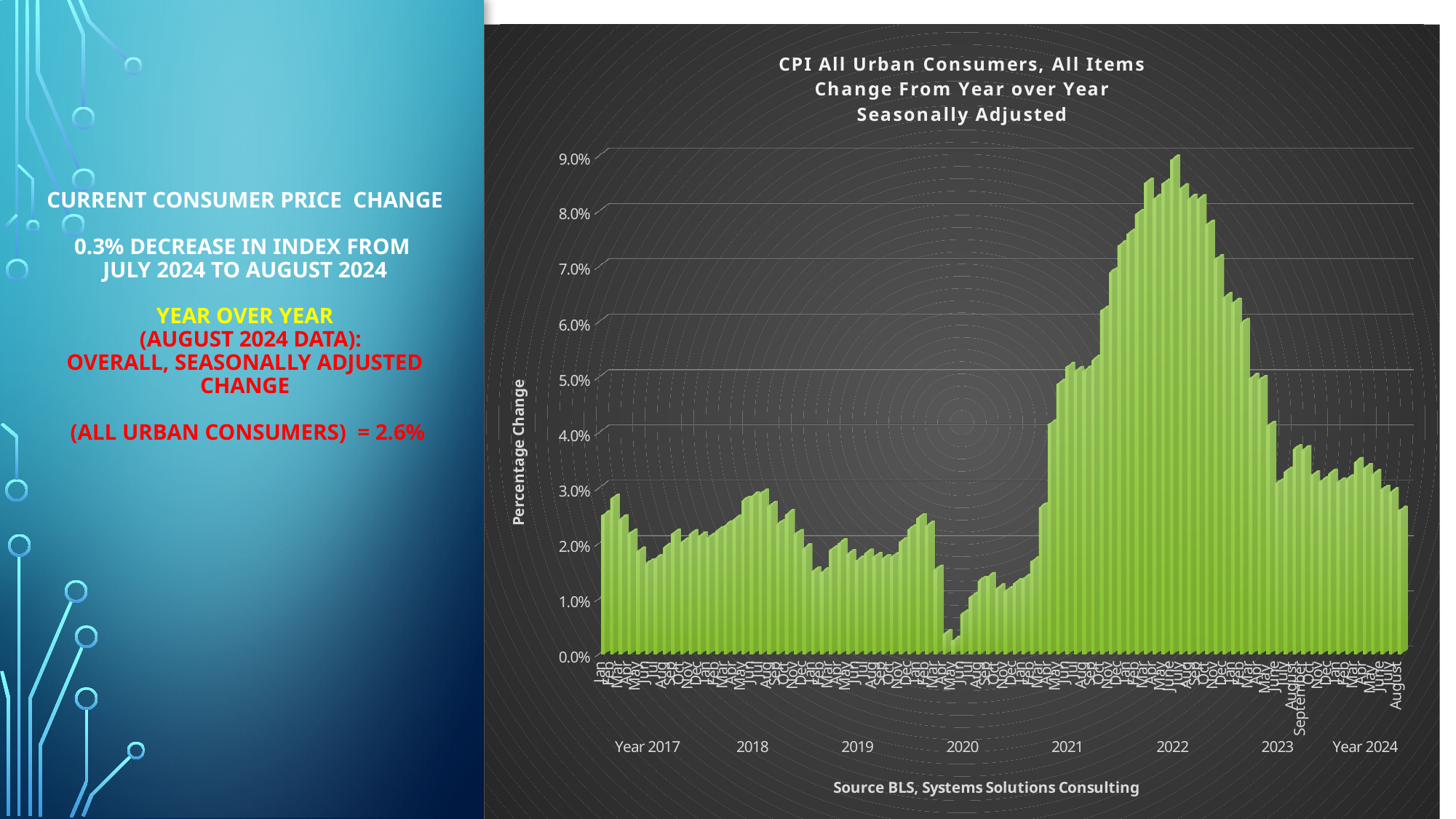
What source is cited below the chart? Source BLS, Systems Solutions Consulting What is the title of the chart? CPI All Urban Consumers, All Items Change From Year over Year Seasonally Adjusted Is the lowest bar in 2020 greater or less than 1.0%? less Do the values rise or fall from the 2022 peak through to August 2024? fall Which is larger, the peak value in 2022 or the peak value in 2018? 2022 Is the highest bar in 2022 greater or less than 8.0%? greater Is the highest bar in 2019 greater or less than 3.0%? less In which year does the chart reach its lowest value? 2020 In which year does the chart reach its highest value? 2022 What kind of chart is shown on the slide? bar chart How many year labels are shown along the x axis? 8